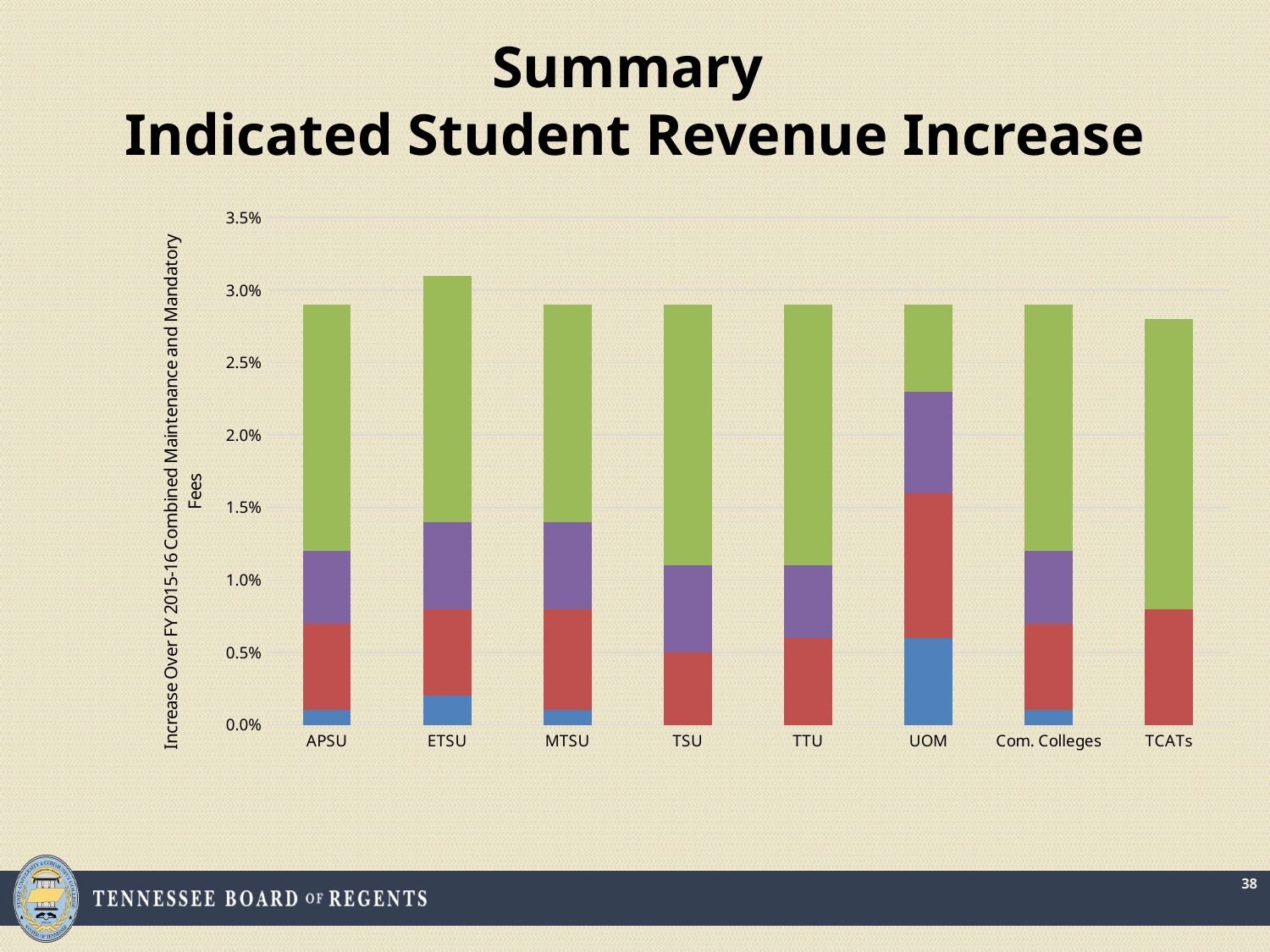
Which has the taller stacked bar, ETSU or MTSU? ETSU Which has the taller stacked bar, ETSU or TCATs? ETSU Is the total bar height for ETSU greater or less than 3.0%? greater Is the total bar height for APSU greater or less than 3.0%? less What is the title of the slide? Summary Indicated Student Revenue Increase What is the label on the vertical axis? Increase Over FY 2015-16 Combined Maintenance and Mandatory Fees Which category has the tallest stacked bar? ETSU Is the top of the purple segment for UOM greater or less than 2.0%? greater How many institutions or groups are shown along the x axis? 8 What kind of chart is shown on the slide? Stacked bar chart